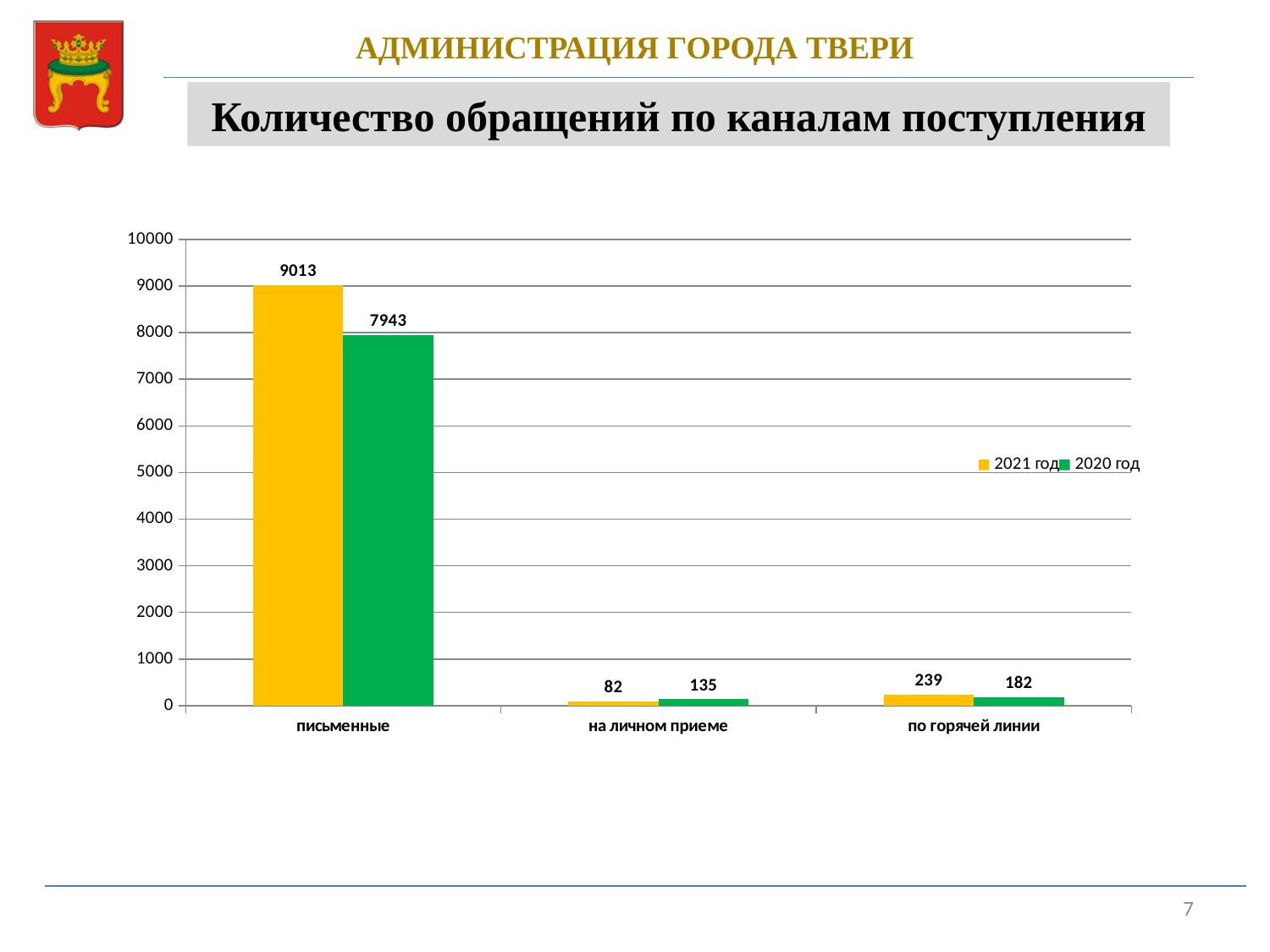
What is the value for по горячей линии in the 2021 год series? 239 Which category has the highest value in the 2020 год series? письменные Which is larger for по горячей линии: the 2021 год value or the 2020 год value? 2021 год What is the difference between the 2021 год and 2020 год values for письменные? 1070 What is the difference between the 2020 год and 2021 год values for на личном приеме? 53 Is the 2020 год value for письменные greater or less than 8000? less How many series does the legend list? 2 What is the value for письменные in the 2021 год series? 9013 What kind of chart is shown on the slide? bar chart Which category has the lowest value in the 2021 год series? на личном приеме What is the value for на личном приеме in the 2020 год series? 135 How many categories are shown on the x axis? 3